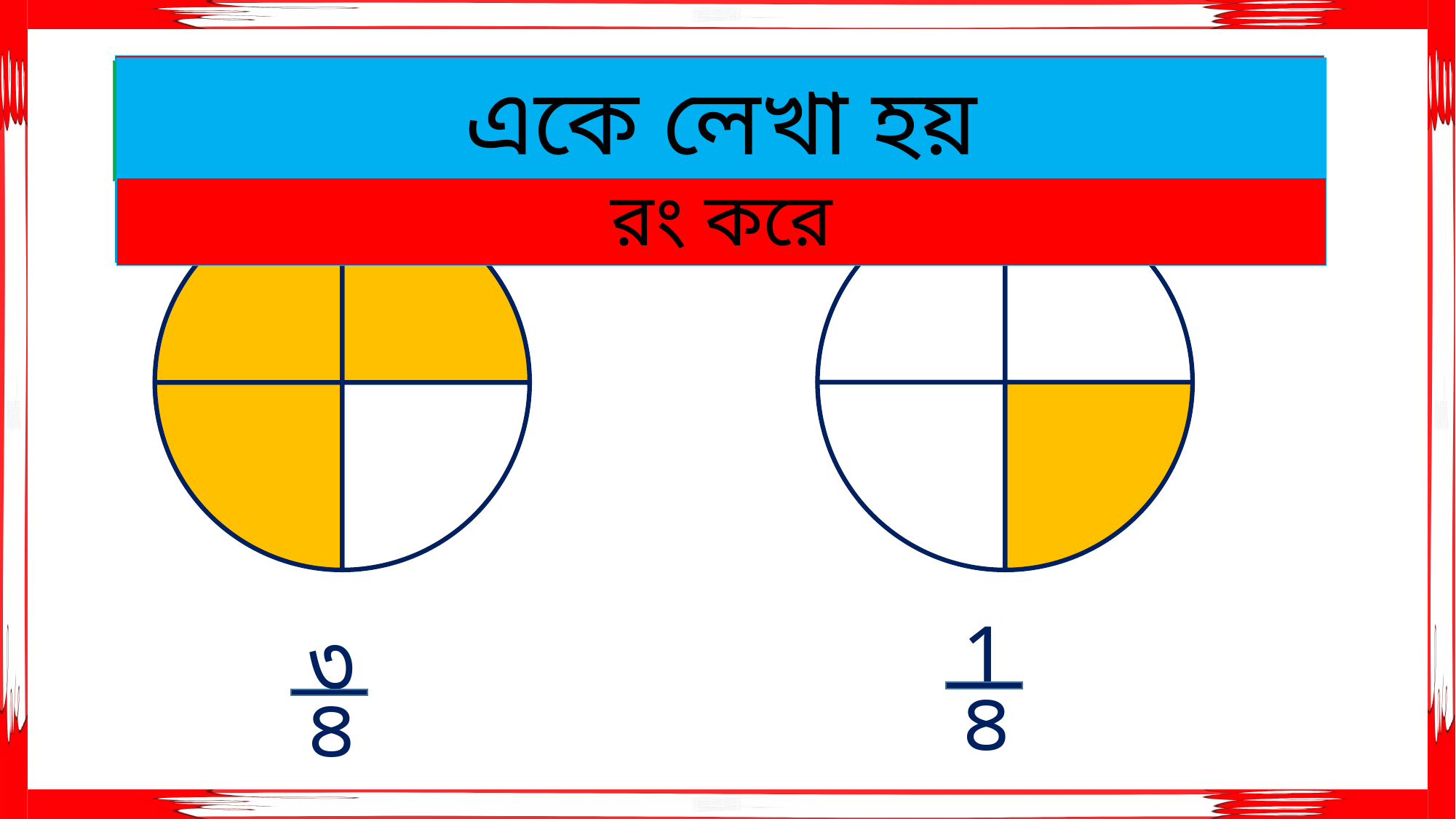
What colour is used to shade the parts of the circles? yellow How many equal parts is the left circle divided into? 4 Which circle has the larger shaded share, the left or the right? left What fraction is written below the right circle? 1/৪ How many equal parts is the right circle divided into? 4 How many circle diagrams are shown on the slide? 2 How many parts of the right circle are shaded yellow? 1 How many parts of the left circle are shaded yellow? 3 Which circle has the smaller shaded share, the left or the right? right What fraction is written below the left circle? ৩/৪